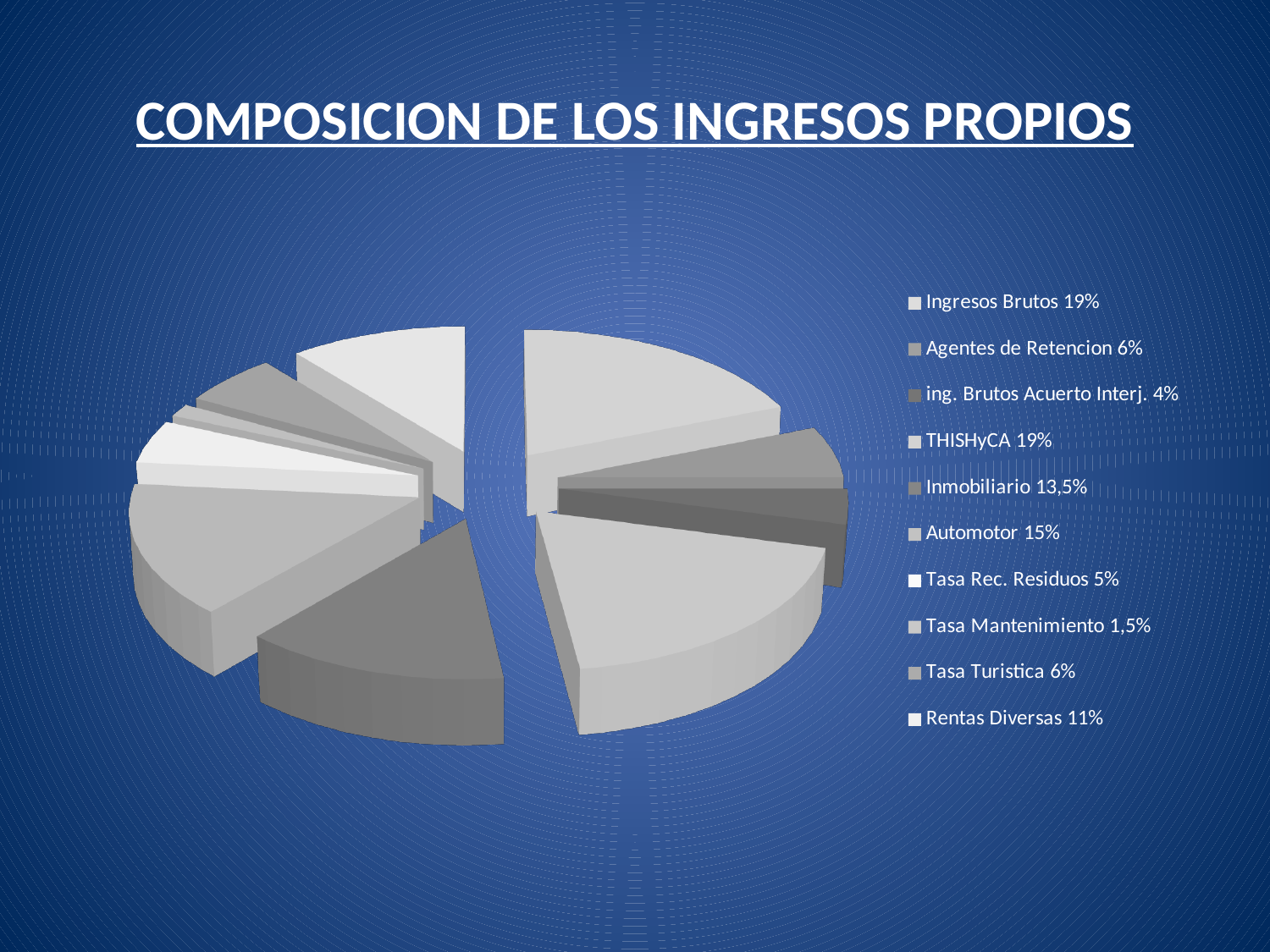
Which is larger, the share of Inmobiliario or the share of Rentas Diversas? Inmobiliario What is the title of the chart? COMPOSICION DE LOS INGRESOS PROPIOS What share does ing. Brutos Acuerto Interj. have? 4% How many categories does the legend list? 10 What is the difference between the shares of Automotor and Rentas Diversas? 4% What share does Inmobiliario have? 13,5% What share does Tasa Rec. Residuos have? 5% What share does Rentas Diversas have? 11% Which category has the smallest share? Tasa Mantenimiento What is the combined share of Ingresos Brutos and THISHyCA? 38% What kind of chart is shown on the slide? pie chart What share does Automotor have? 15%